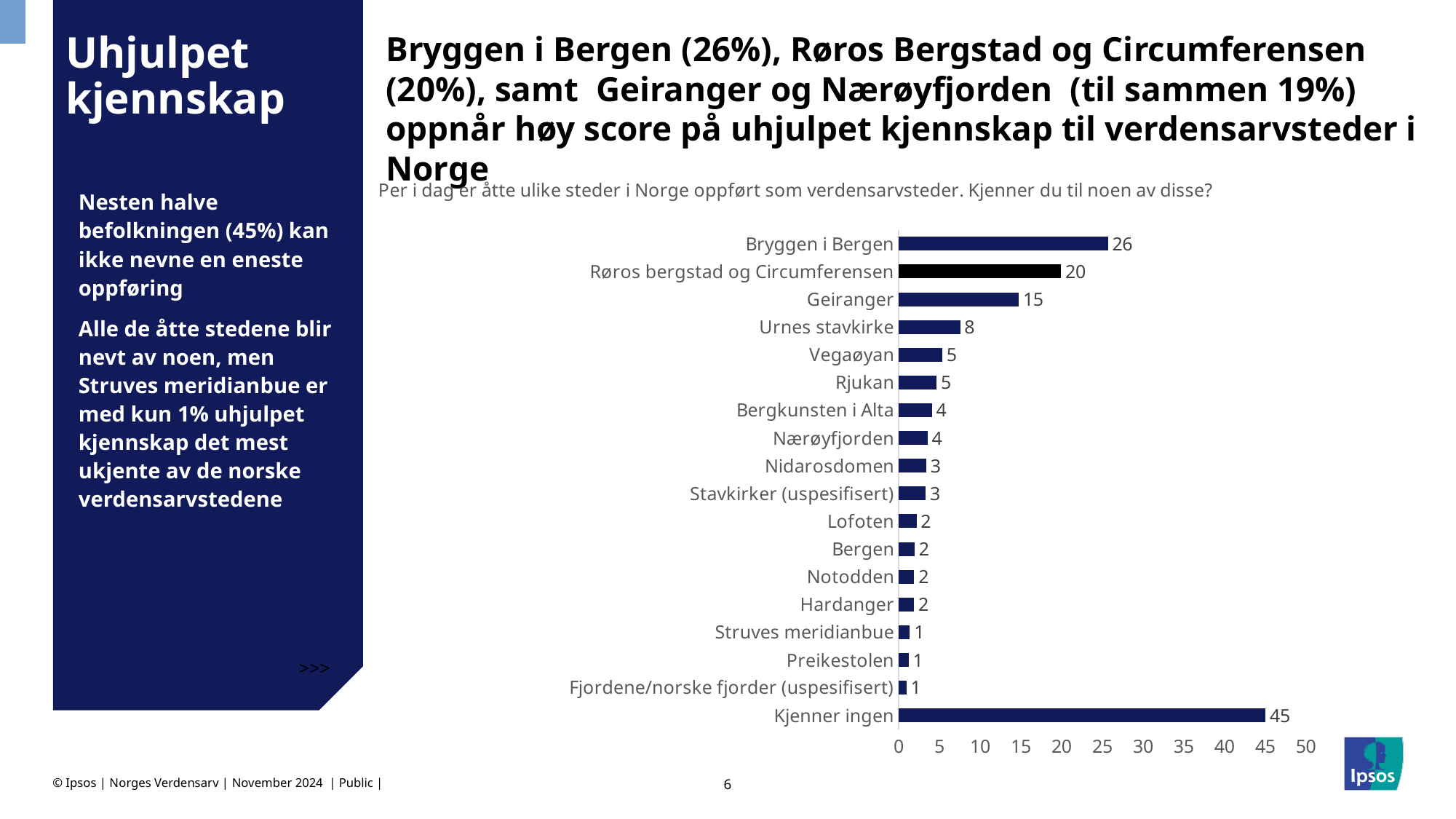
Which has a larger value, Nidarosdomen or Nærøyfjorden? Nærøyfjorden Which bar in the chart is coloured black rather than dark blue? Røros bergstad og Circumferensen What is the difference between the values for Bryggen i Bergen and Geiranger? 11 What type of chart is shown on the slide? bar chart Which category has the highest value in the chart? Kjenner ingen What is the value for Røros bergstad og Circumferensen? 20 What is the value for Bryggen i Bergen? 26 Which has a larger value, Geiranger or Urnes stavkirke? Geiranger How many categories are shown in the chart? 18 What is the value for Urnes stavkirke? 8 What is the value for Struves meridianbue? 1 What is the difference between the values for Kjenner ingen and Bryggen i Bergen? 19